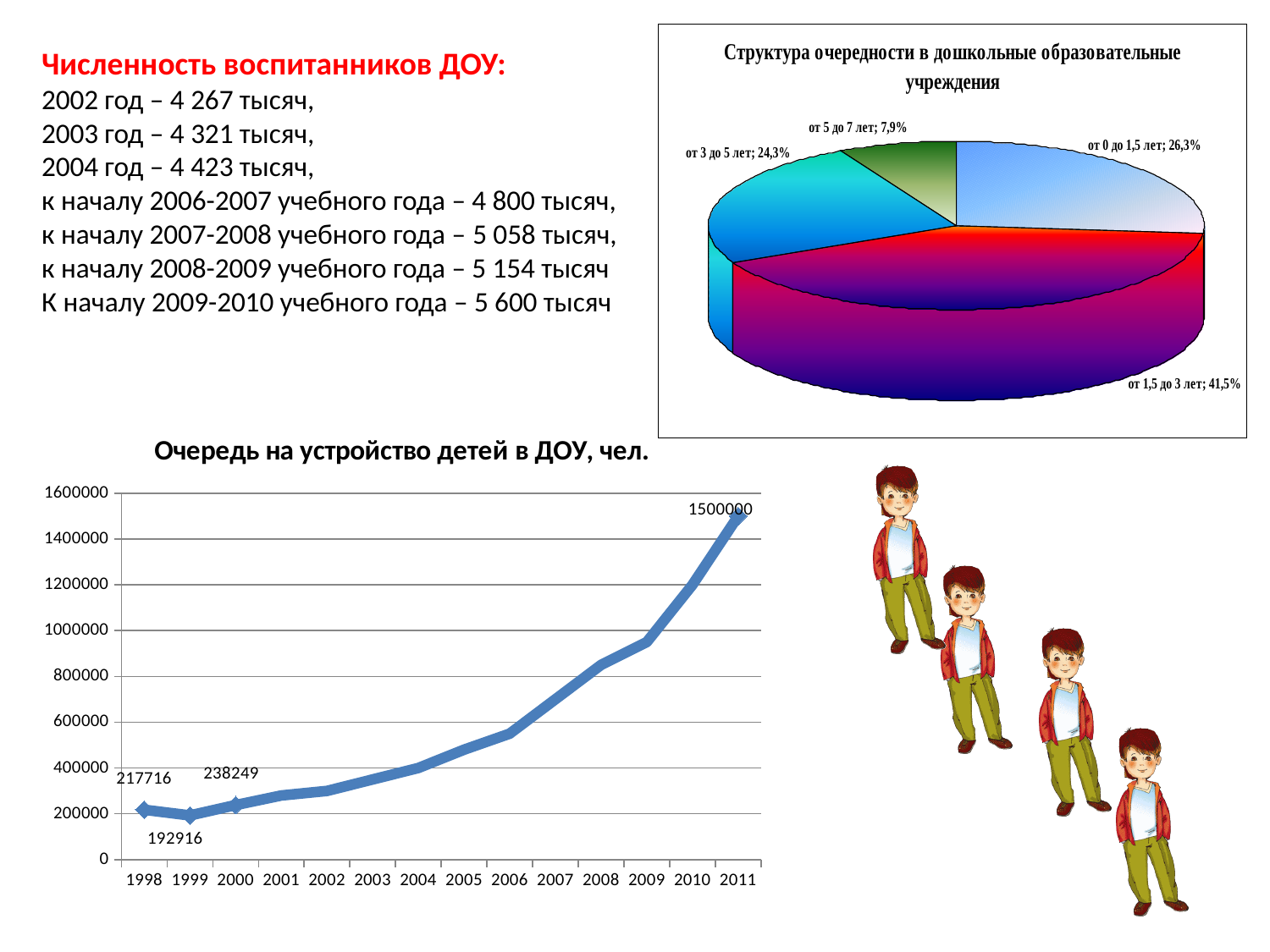
In the pie chart 'Структура очередности в дошкольные образовательные учреждения', what share is shown for 'от 5 до 7 лет'? 7,9% In the pie chart 'Структура очередности в дошкольные образовательные учреждения', which share is larger: 'от 0 до 1,5 лет' or 'от 3 до 5 лет'? от 0 до 1,5 лет In the pie chart 'Структура очередности в дошкольные образовательные учреждения', what share is shown for 'от 1,5 до 3 лет'? 41,5% In the pie chart 'Структура очередности в дошкольные образовательные учреждения', which age group has the smallest share? от 5 до 7 лет In the pie chart 'Структура очередности в дошкольные образовательные учреждения', how many slices are there? 4 In the chart 'Очередь на устройство детей в ДОУ, чел.', is the value for 2008 greater or less than 800000? greater In the chart 'Очередь на устройство детей в ДОУ, чел.', do the values generally rise or fall from 2000 to 2011? rise What kind of chart is 'Очередь на устройство детей в ДОУ, чел.'? line chart In the pie chart 'Структура очередности в дошкольные образовательные учреждения', which age group has the largest share? от 1,5 до 3 лет In the chart 'Очередь на устройство детей в ДОУ, чел.', what is the difference between the values for 2000 and 1998? 20533 In the chart 'Очередь на устройство детей в ДОУ, чел.', what is the value for 2011? 1500000 In the chart 'Очередь на устройство детей в ДОУ, чел.', what is the value for 1999? 192916